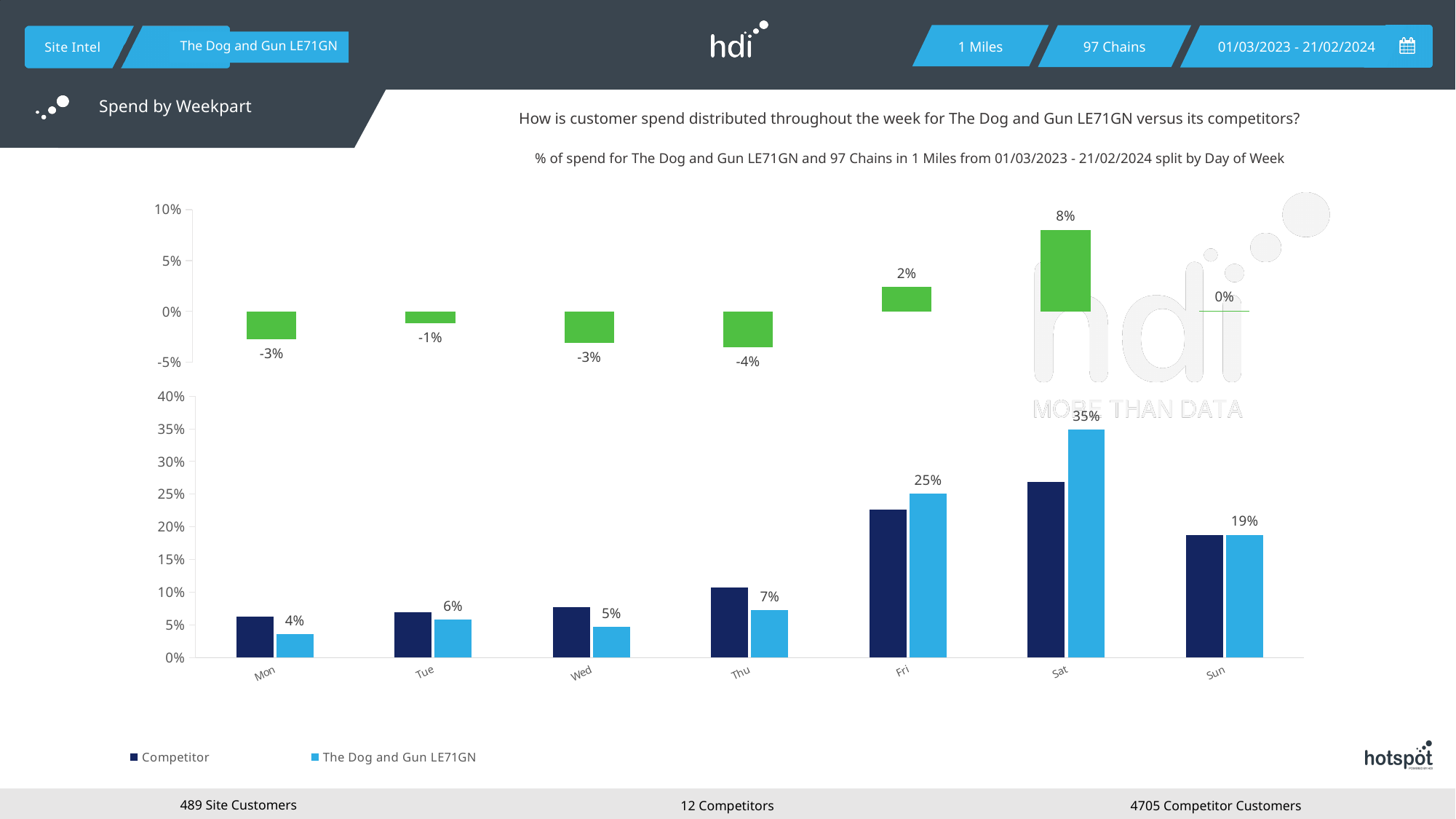
In the bottom chart, what is the value for The Dog and Gun LE71GN on Fri? 25% In the bottom chart, is the Competitor value for Thu greater or less than 15%? less How many series does the legend of the bottom chart list? 2 In the bottom chart, what is the value for The Dog and Gun LE71GN on Sat? 35% In the top chart, which day has the lowest value? Thu In the top chart, what is the value shown for Thu? -4% In the bottom chart, which day has the highest value for The Dog and Gun LE71GN? Sat How many days of the week are shown on the x axis of the bottom chart? 7 In the bottom chart, what is the difference between The Dog and Gun LE71GN values for Sat and Fri? 10% In the top chart, what is the value shown for Sat? 8% In the bottom chart, which day has the lowest value for The Dog and Gun LE71GN? Mon In the bottom chart, is the Competitor value for Sat greater or less than 25%? greater